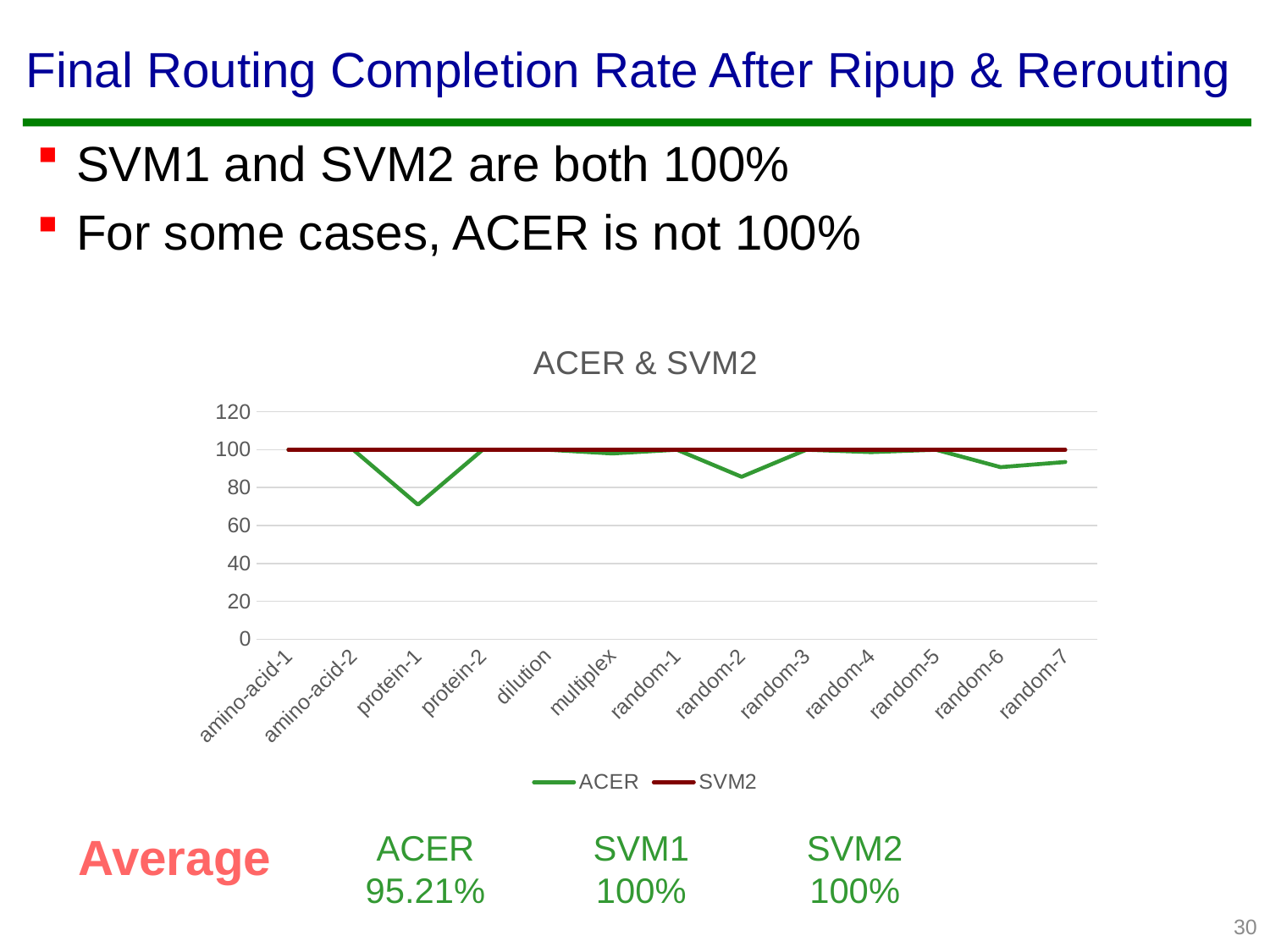
What is the SVM2 value for dilution? 100 Is the ACER value for amino-acid-1 greater or less than 80? greater What kind of chart is shown on the slide? line chart What is the title of the chart? ACER & SVM2 Is the ACER value for random-2 greater or less than 80? greater Which series is drawn in green in the chart? ACER For which category is the ACER value lowest? protein-1 How many categories are plotted along the x axis of the chart? 13 Is the ACER value for random-6 greater or less than 80? greater At protein-1, which series has the larger value, ACER or SVM2? SVM2 How many series does the chart legend list? 2